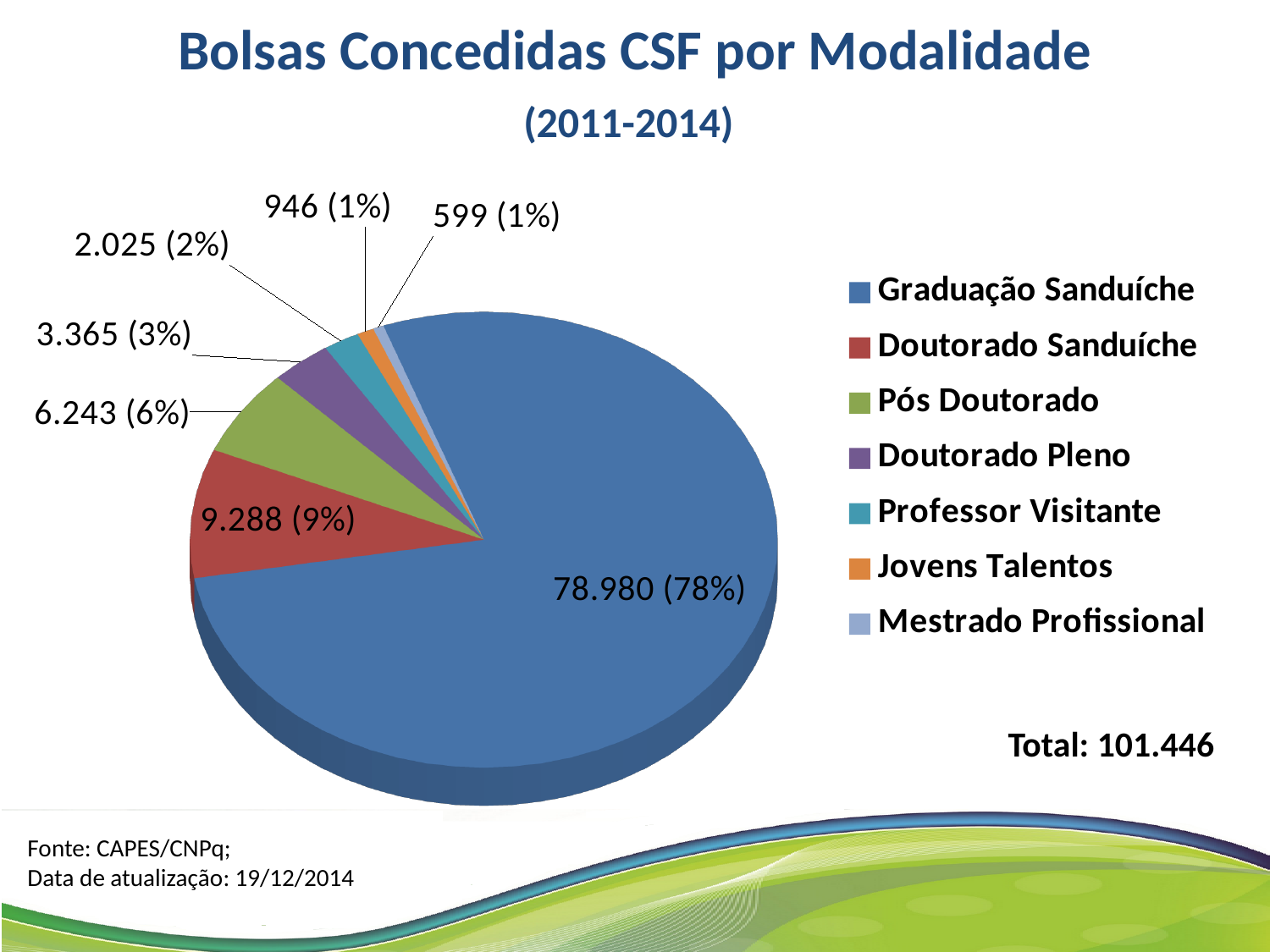
What is the value for Professor Visitante? 2.025 (2%) What is the title of the chart? Bolsas Concedidas CSF por Modalidade (2011-2014) Which is larger, Jovens Talentos or Mestrado Profissional? Jovens Talentos Which category has the largest slice? Graduação Sanduíche Which category has the smallest slice? Mestrado Profissional What is the difference between the values for Doutorado Sanduíche and Pós Doutorado? 3.045 What is the value for Graduação Sanduíche? 78.980 (78%) How many categories does the legend list? 7 What is the value for Pós Doutorado? 6.243 (6%) What kind of chart is shown on the slide? pie chart What is the value for Doutorado Sanduíche? 9.288 (9%) What share of the pie does Doutorado Pleno represent? 3%